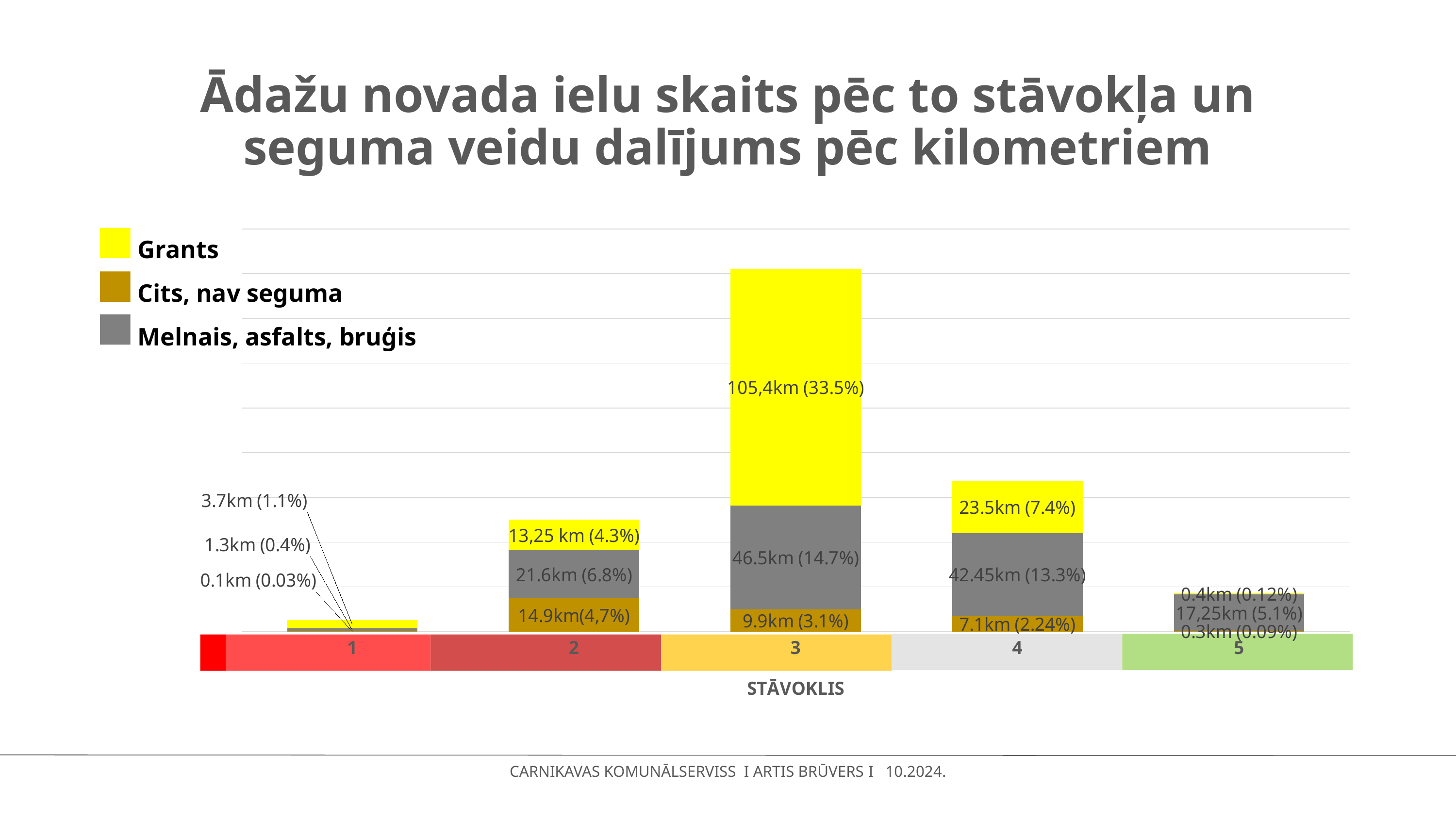
How many series does the legend list? 3 How many categories are shown on the x axis? 5 What is the title of the x axis? STĀVOKLIS Which category has the shortest stacked bar? 1 What is the value of Cits, nav seguma for category 2? 14.9km(4,7%) What type of chart is shown on the slide? Stacked bar chart Which is larger, the Grants value for category 3 or for category 4? Category 3 Which category has the tallest stacked bar? 3 What is the value of Melnais, asfalts, bruģis for category 4? 42.45km (13.3%) What is the value of Grants for category 3? 105,4km (33.5%) What is the value of Melnais, asfalts, bruģis for category 5? 17,25km (5.1%) What is the difference between the Melnais, asfalts, bruģis values for category 3 and category 4? 4.05km